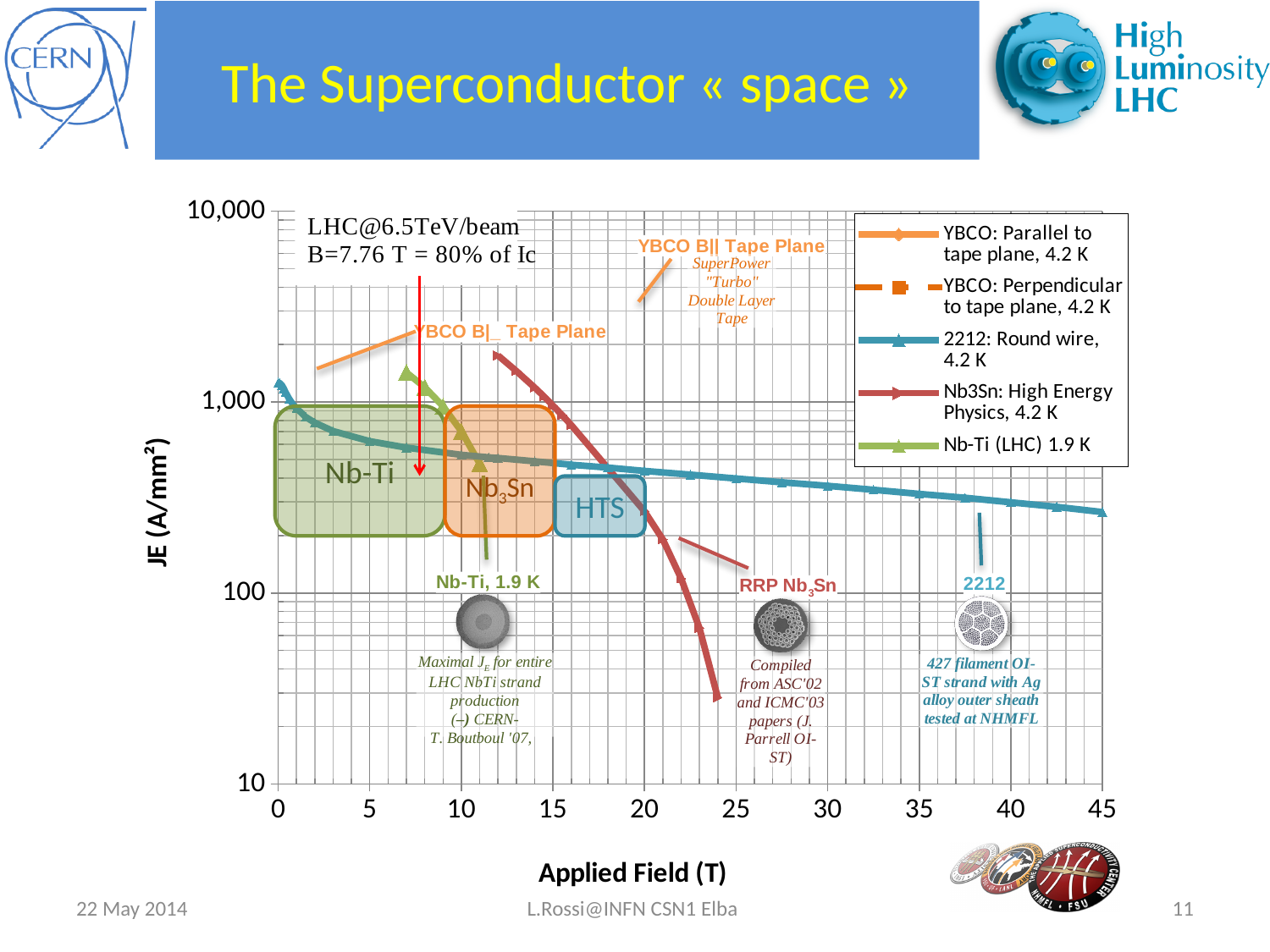
At an applied field of 22 T, which series has the higher JE value: 2212 round wire or Nb3Sn? 2212 round wire Does the JE value of the Nb3Sn series rise or fall as the applied field increases? fall How many series does the chart legend list? 5 What is the label of the x axis of the chart? Applied Field (T) Does the JE value of the 2212 round wire series rise or fall as the applied field increases? fall Is the JE value of the 2212 round wire series at 45 T greater or less than 1,000? less What kind of chart is shown on the slide? line chart Is the JE value of the Nb3Sn series at 24 T greater or less than 100? less At an applied field of 12 T, which series has the higher JE value: Nb3Sn or 2212 round wire? Nb3Sn Is the JE value of the 2212 round wire series at 45 T greater or less than 100? greater What is the label of the y axis of the chart? JE (A/mm²)